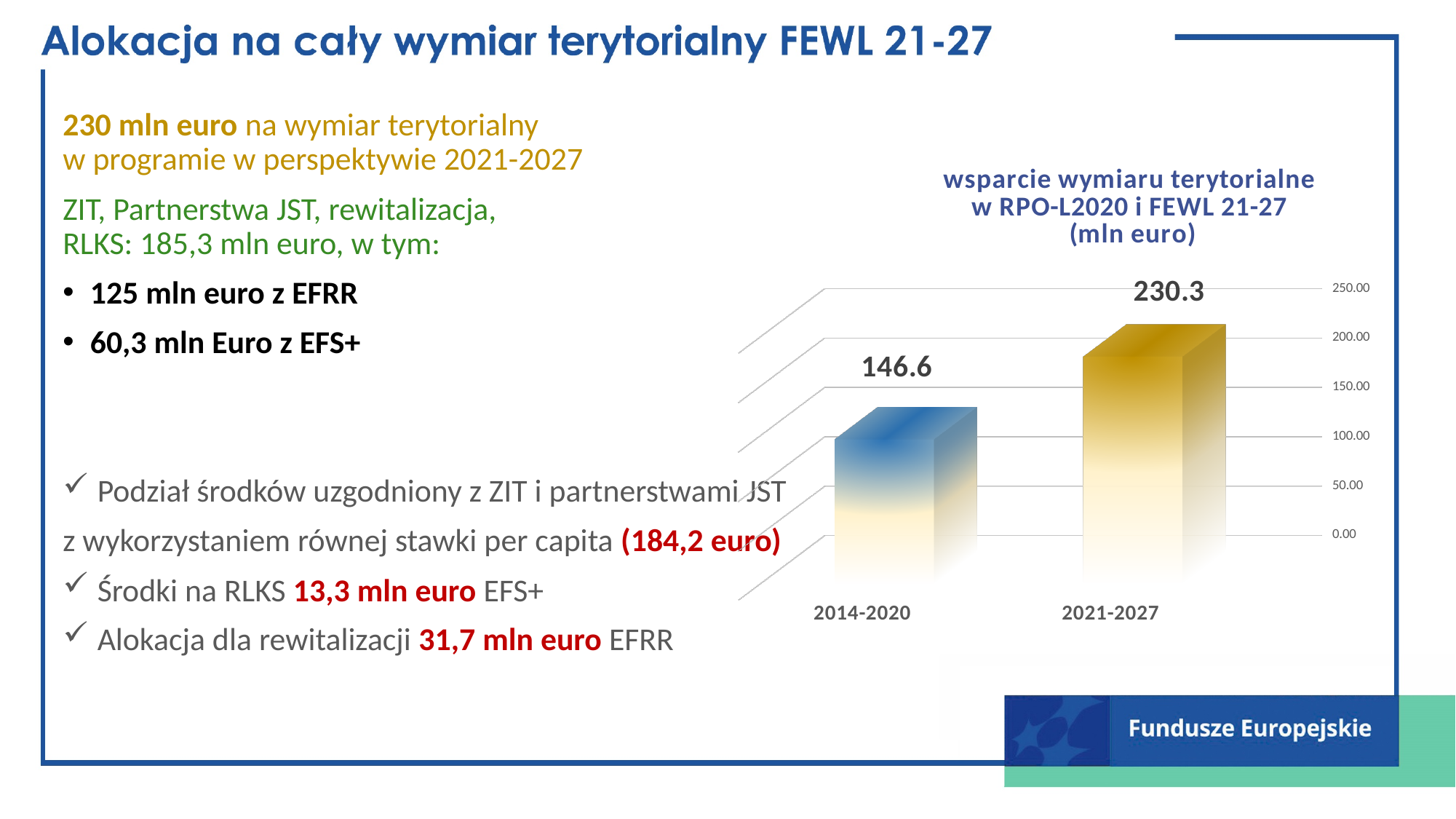
What is the value for 2021-2027 in the chart? 230.3 Which period has the lower value in the chart? 2014-2020 What is the highest tick value shown on the chart's vertical axis? 250.00 How many categories are shown on the x axis of the chart? 2 What unit is given in the chart title? mln euro What is the difference between the 2021-2027 value and the 2014-2020 value? 83.7 Is the value for 2014-2020 greater or less than 150.00? less What is the value for 2014-2020 in the chart? 146.6 Do the values rise or fall from 2014-2020 to 2021-2027? rise Which period has the higher value in the chart? 2021-2027 What kind of chart is shown on the slide? bar chart Is the value for 2021-2027 greater or less than 200.00? greater